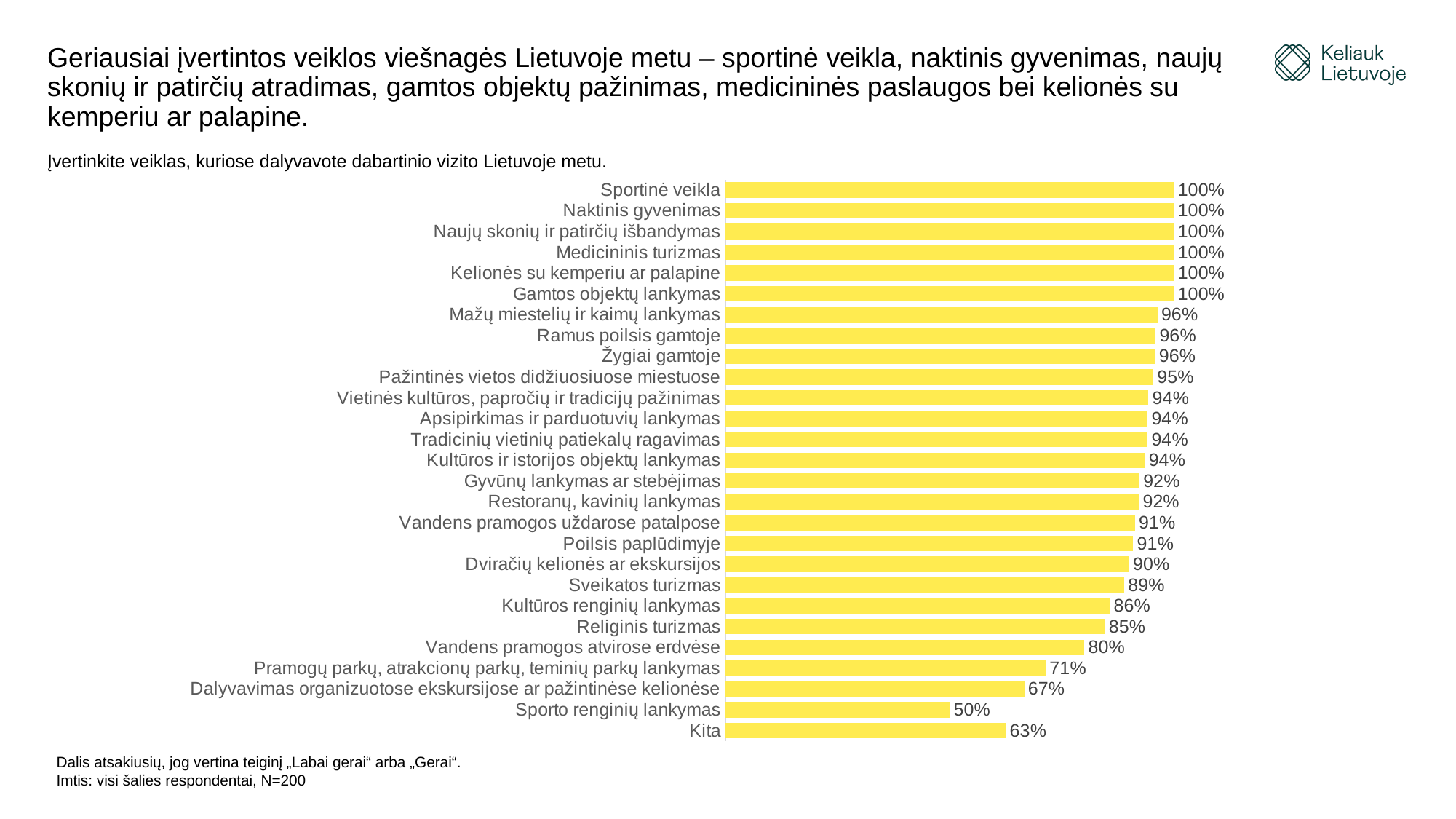
What is the value for Dviračių kelionės ar ekskursijos? 90% What is the value for Religinis turizmas? 85% What is the difference between the values for Sportinė veikla and Kita? 37% Which is larger, the value for Sveikatos turizmas or the value for Religinis turizmas? Sveikatos turizmas What is the value for Kita? 63% Which is larger, the value for Kita or the value for Dalyvavimas organizuotose ekskursijose ar pažintinėse kelionėse? Dalyvavimas organizuotose ekskursijose ar pažintinėse kelionėse What is the difference between the values for Vandens pramogos atvirose erdvėse and Sporto renginių lankymas? 30% What is the value for Sporto renginių lankymas? 50% What kind of chart is shown on the slide? bar chart What is the value for Pramogų parkų, atrakcionų parkų, teminių parkų lankymas? 71% Which category has the lowest value? Sporto renginių lankymas How many categories are shown in the chart? 27